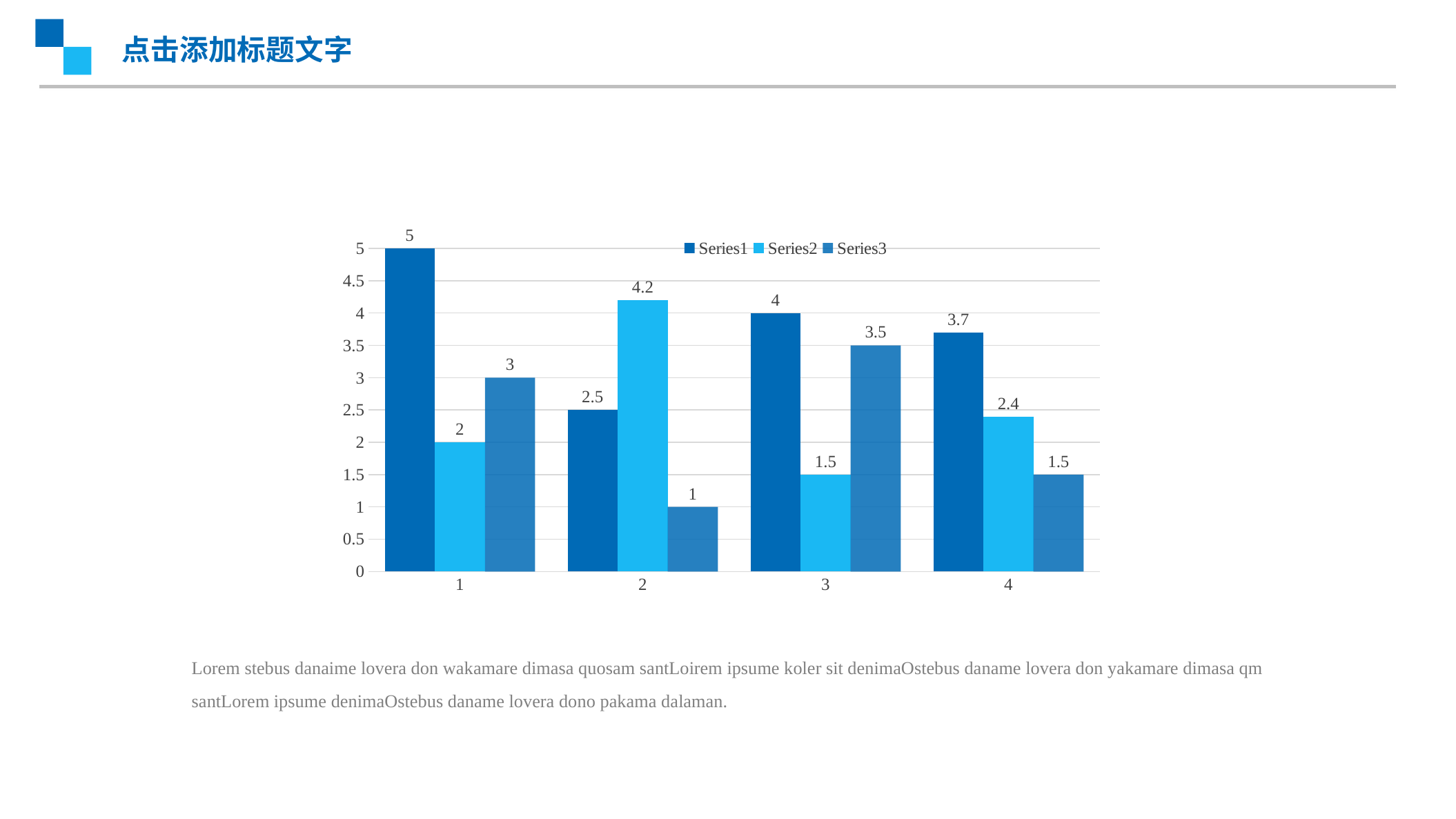
How many categories are shown on the x axis? 4 What is the value of Series3 for category 3? 3.5 What is the value of Series2 for category 2? 4.2 What is the difference between Series1 and Series2 for category 3? 2.5 Which category has the highest value for Series1? 1 Which category has the lowest value for Series3? 2 What is the value of Series1 for category 1? 5 What is the total of the three series for category 4? 7.6 What kind of chart is shown on the slide? bar chart What is the value of Series1 for category 4? 3.7 How many series does the legend list? 3 Which is larger for category 2: Series1 or Series2? Series2